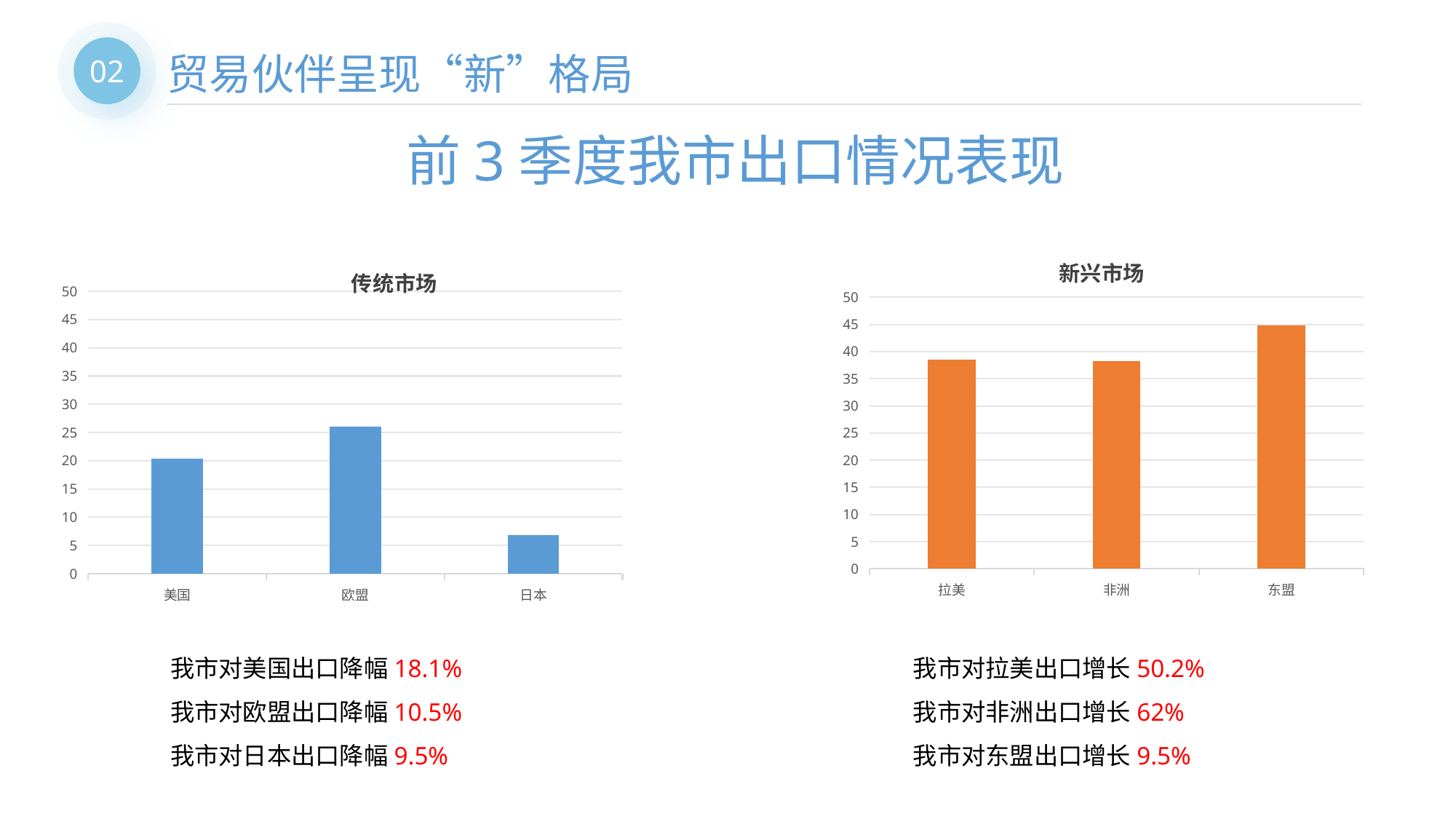
What kind of chart is the 新兴市场 chart? bar chart In the 传统市场 chart, is the value for 美国 greater or less than 15? greater In the 新兴市场 chart, is the value for 东盟 greater or less than 40? greater In the 传统市场 chart, which category has the highest value? 欧盟 How many categories are shown in the 传统市场 chart? 3 In the 传统市场 chart, which is larger, the value for 美国 or the value for 日本? 美国 In the 传统市场 chart, which category has the lowest value? 日本 In the 新兴市场 chart, which category has the highest value? 东盟 In the 传统市场 chart, is the value for 欧盟 greater or less than 30? less What colour are the bars in the 新兴市场 chart? orange